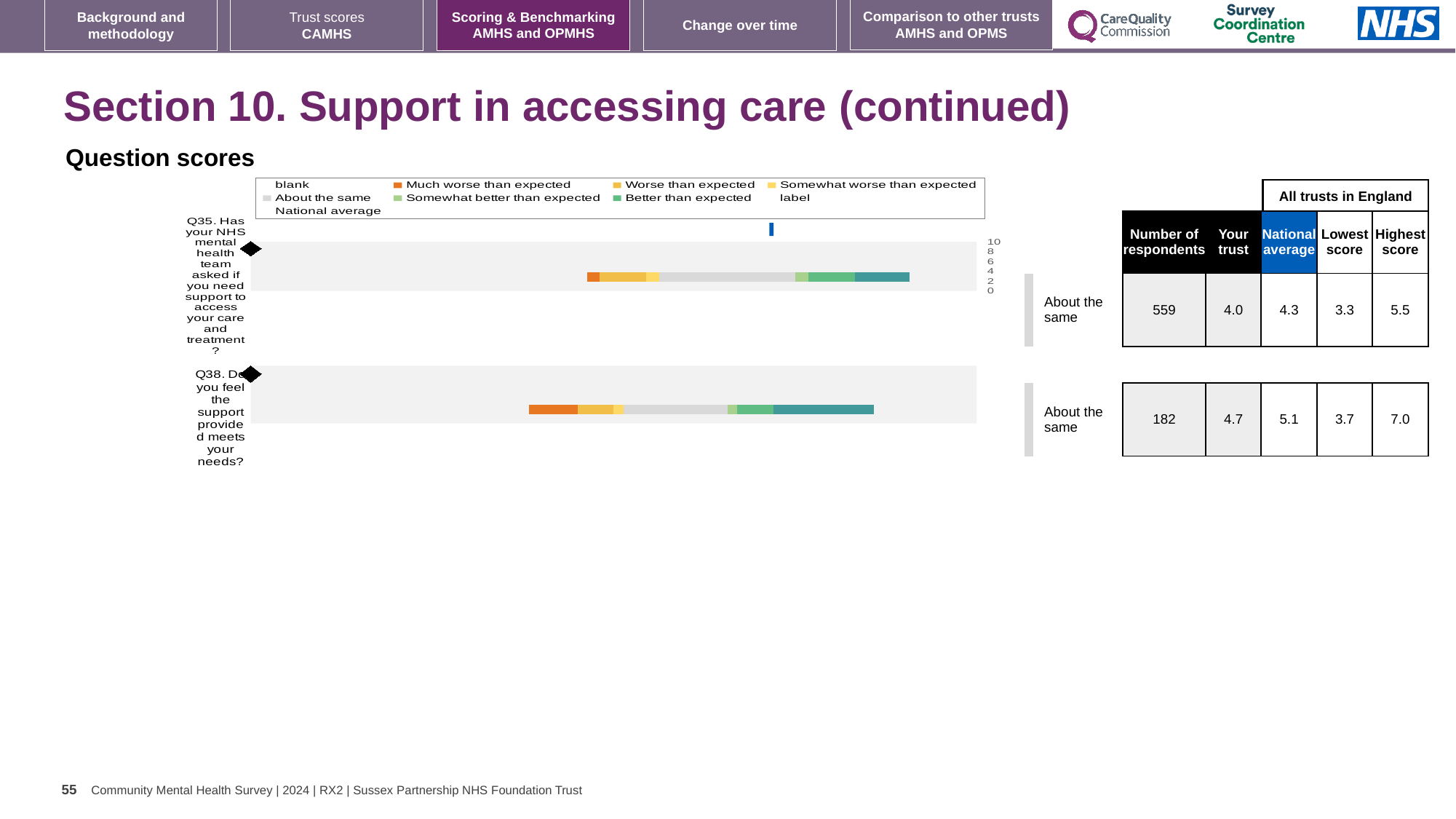
What benchmark category is shown for Q35? About the same Which question has the higher 'Your trust' score, Q35 or Q38? Q38 What is the 'Your trust' score for Q35 (Has your NHS mental health team asked if you need support to access your care and treatment?)? 4.0 Which legend entry is shown in dark orange? Much worse than expected What is the difference between the highest score and the lowest score for Q35? 2.2 Which is larger for Q38: the 'Your trust' score or the national average? National average What is the difference between the national average and the 'Your trust' score for Q38? 0.4 What kind of chart is shown under 'Question scores'? bar chart What is the highest score among all trusts in England for Q38? 7.0 How many respondents answered Q35? 559 How many questions (bars) are plotted in the chart? 2 What is the national average for Q38 (Do you feel the support provided meets your needs?)? 5.1